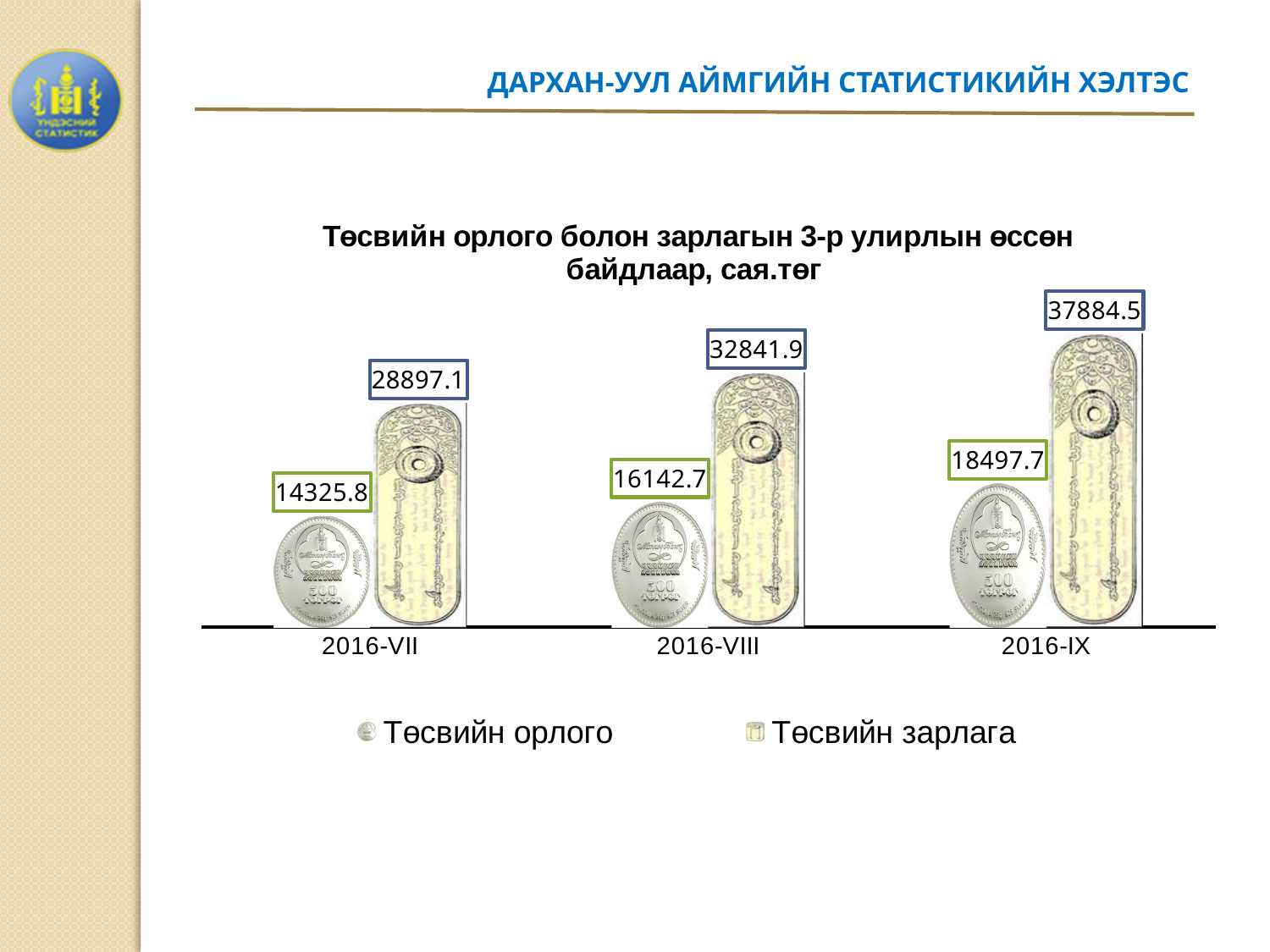
What is the value of Төсвийн орлого for 2016-IX? 18497.7 What is the value of Төсвийн орлого for 2016-VII? 14325.8 What is the value of Төсвийн зарлага for 2016-IX? 37884.5 Does Төсвийн орлого rise or fall from 2016-VII to 2016-IX? rise How many periods are shown on the x axis? 3 What is the difference between Төсвийн зарлага and Төсвийн орлого in 2016-VII? 14571.3 What is the value of Төсвийн зарлага for 2016-VIII? 32841.9 By how much did Төсвийн зарлага increase from 2016-VIII to 2016-IX? 5042.6 Which is larger in 2016-VIII, Төсвийн орлого or Төсвийн зарлага? Төсвийн зарлага In which period is Төсвийн зарлага highest? 2016-IX In which period is Төсвийн орлого lowest? 2016-VII How many series does the legend list? 2